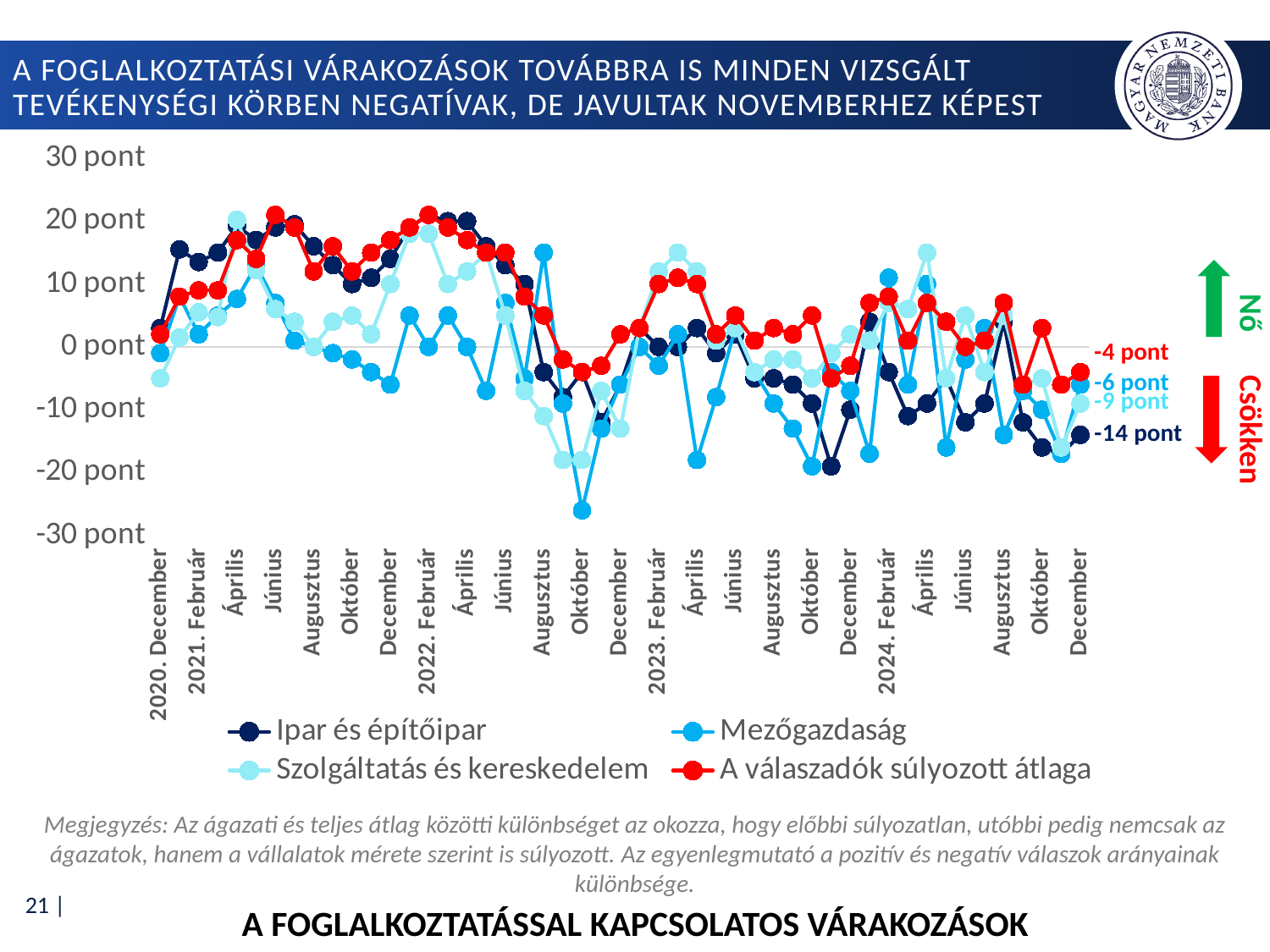
Which series has the highest value at the end of the series (2024 December)? A válaszadók súlyozott átlaga What is the difference between the final values of A válaszadók súlyozott átlaga and Ipar és építőipar? 10 pont At the end of the series, which is larger: the value for Mezőgazdaság or for Szolgáltatás és kereskedelem? Mezőgazdaság What is the value for A válaszadók súlyozott átlaga at the end of the series (2024 December)? -4 pont What is the value for Szolgáltatás és kereskedelem at the end of the series (2024 December)? -9 pont What kind of chart is shown on the slide? line chart Which series is drawn in red? A válaszadók súlyozott átlaga How many series does the legend list? 4 Which series has the lowest value at the end of the series (2024 December)? Ipar és építőipar What is the value for Mezőgazdaság at the end of the series (2024 December)? -6 pont What is the value for Ipar és építőipar at the end of the series (2024 December)? -14 pont Is the value for Mezőgazdaság in 2022 Október greater or less than -20 pont? less